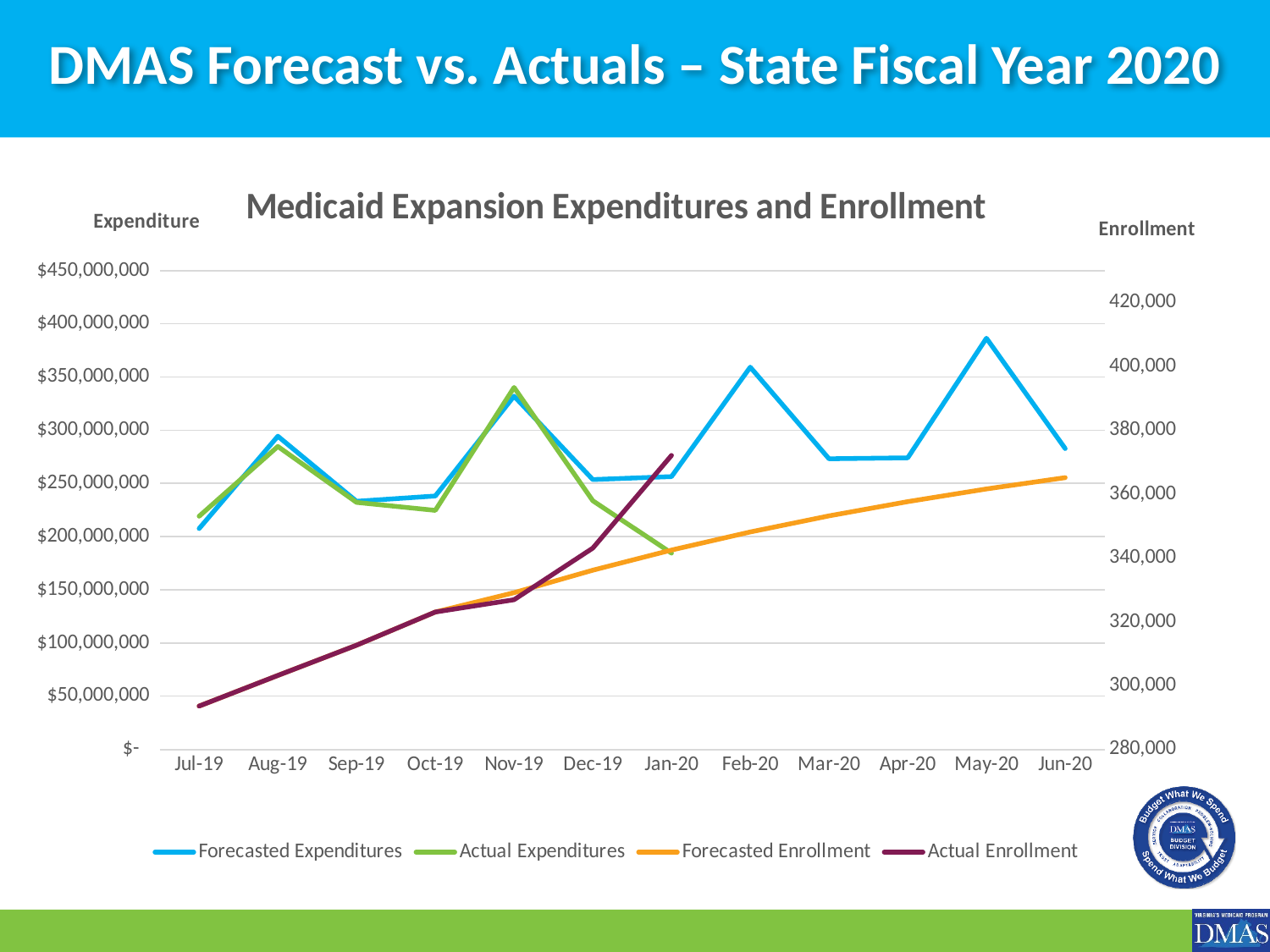
Is the value for Actual Expenditures in Jan-20 greater or less than $200,000,000? less Is the value for Actual Enrollment in Jul-19 greater or less than 300,000? less In which month do Actual Expenditures reach their highest value? Nov-19 How many months are shown along the x axis? 12 How many series does the legend list? 4 Does Actual Enrollment rise or fall from Jul-19 to Jan-20? rise In which month are Forecasted Expenditures at their lowest? Jul-19 What kind of chart is shown on the slide? line chart In Jan-20, which is larger: Forecasted Expenditures or Actual Expenditures? Forecasted Expenditures In which month do Forecasted Expenditures reach their highest value? May-20 What is the title of the chart? Medicaid Expansion Expenditures and Enrollment Is the value for Forecasted Expenditures in May-20 greater or less than $350,000,000? greater